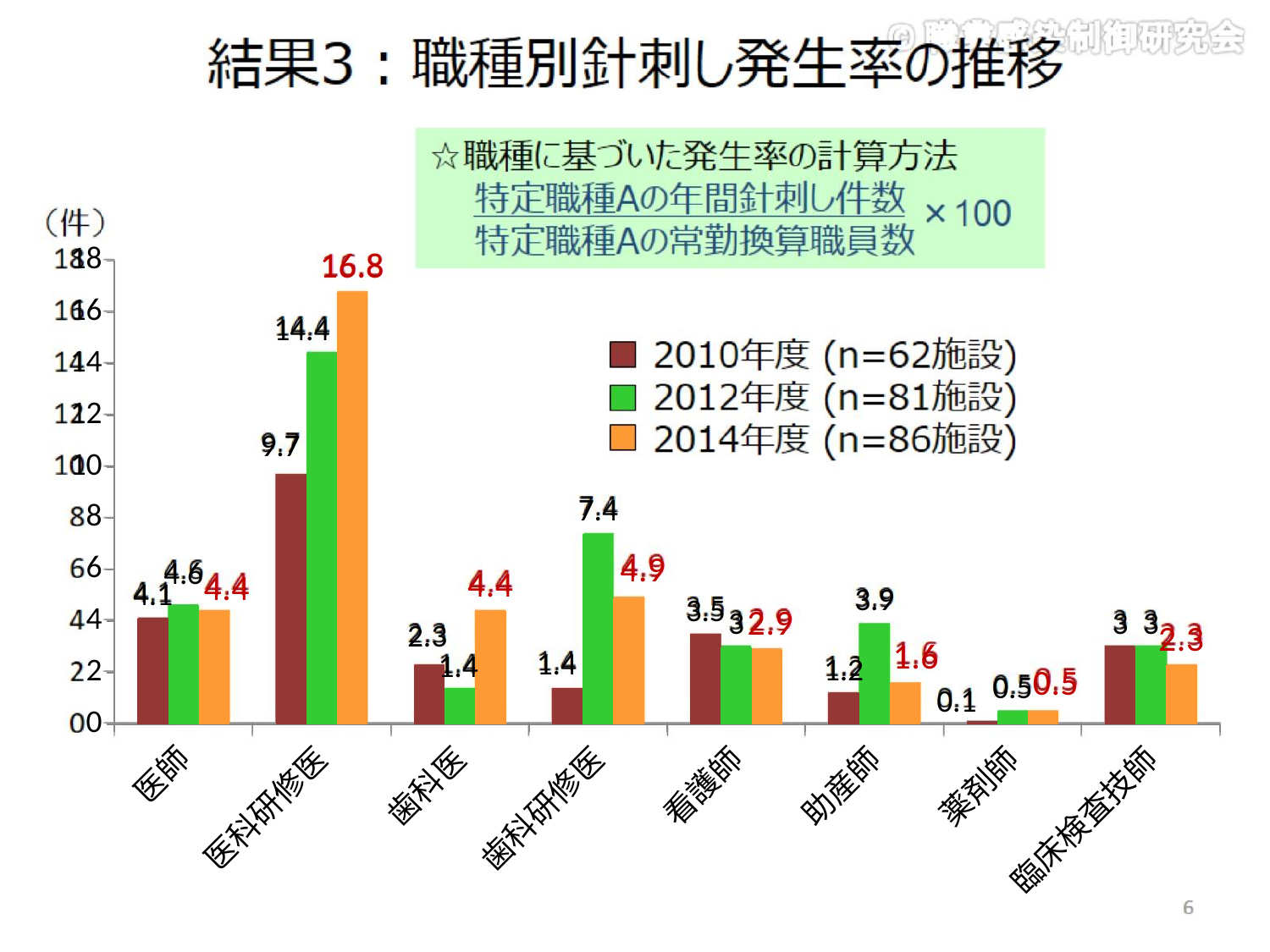
Which job category has the highest value in 2014年度? 医科研修医 What is the difference between the 2014年度 and 2012年度 values for 医科研修医? 2.4 What is the value for 薬剤師 in 2010年度? 0.1 What kind of chart is shown on the slide? bar chart Which job category has the lowest value in 2010年度? 薬剤師 How many series does the legend list? 3 Which is larger for 歯科研修医: the 2012年度 value or the 2014年度 value? 2012年度 Do the values for 医科研修医 rise or fall from 2010年度 to 2014年度? rise What is the value for 歯科研修医 in 2012年度? 7.4 What is the value for 医科研修医 in 2012年度? 14.4 How many job categories are shown on the x axis? 8 What is the value for 医科研修医 in 2014年度? 16.8